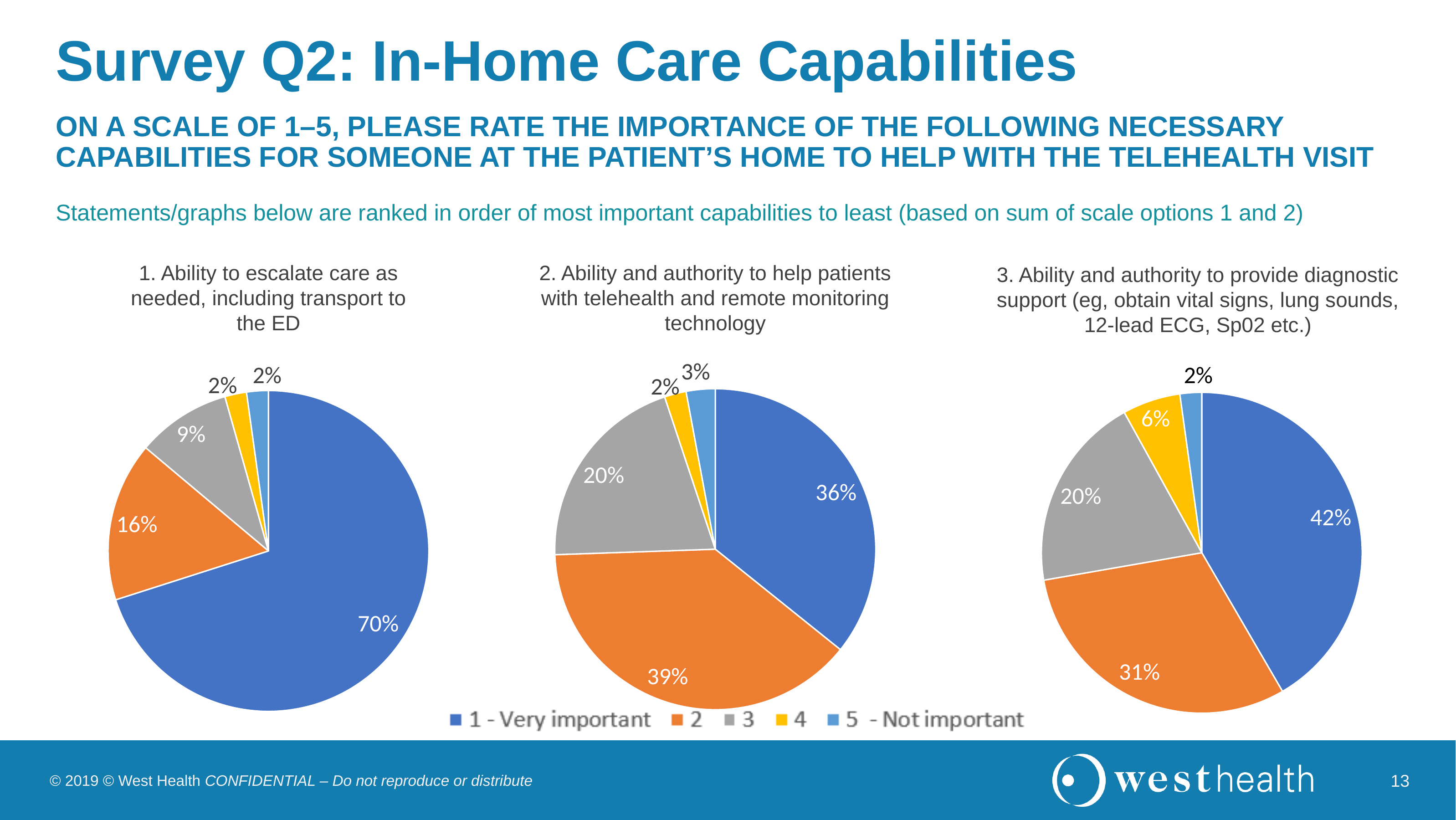
In the third pie chart (Ability and authority to provide diagnostic support), what share gave a rating of 4? 6% In the third pie chart (Ability and authority to provide diagnostic support), what is the difference between the shares for rating 1 - Very important and rating 2? 11% In the first pie chart (Ability to escalate care as needed), what share gave a rating of 2? 16% How many rating categories does the legend list? 5 What kind of charts are shown on the slide? Pie charts In the first pie chart (Ability to escalate care as needed), what share rated it 1 - Very important? 70% Which is larger: the 1 - Very important share in the first pie chart or the 1 - Very important share in the second pie chart? The first pie chart In the second pie chart (Ability and authority to help patients with telehealth and remote monitoring technology), what share gave a rating of 2? 39% In the second pie chart (Ability and authority to help patients with telehealth and remote monitoring technology), which rating has the largest share? 2 In the third pie chart (Ability and authority to provide diagnostic support), what share rated it 1 - Very important? 42% How many pie charts are on the slide? 3 In the second pie chart (Ability and authority to help patients with telehealth and remote monitoring technology), what share gave a rating of 3? 20%